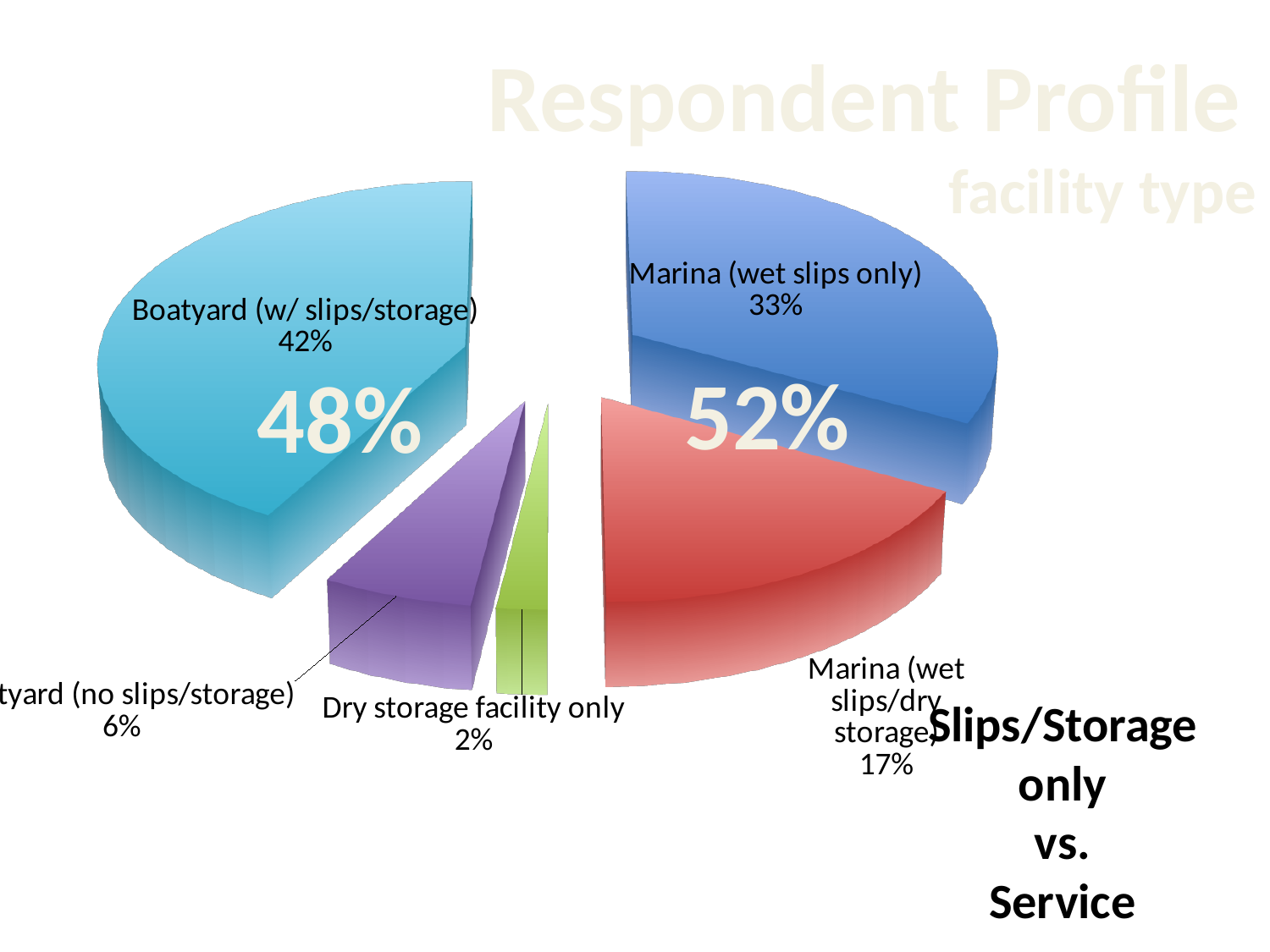
What colour is the Marina (wet slips only) slice? Blue What percentage of respondents are Marina (wet slips/dry storage)? 17% What is the difference between the Boatyard (w/ slips/storage) share and the Marina (wet slips only) share? 9 percentage points What percentage of respondents are Boatyard (w/ slips/storage)? 42% What percentage of respondents are Dry storage facility only? 2% What percentage of respondents are Marina (wet slips only)? 33% Which is larger: the share for Marina (wet slips only) or the share for Marina (wet slips/dry storage)? Marina (wet slips only) What kind of chart is shown on the slide? Pie chart How many slices does the pie chart have? 5 What is the title of the chart? Respondent Profile facility type Which facility type has the largest share of the pie? Boatyard (w/ slips/storage) Which facility type has the smallest share of the pie? Dry storage facility only